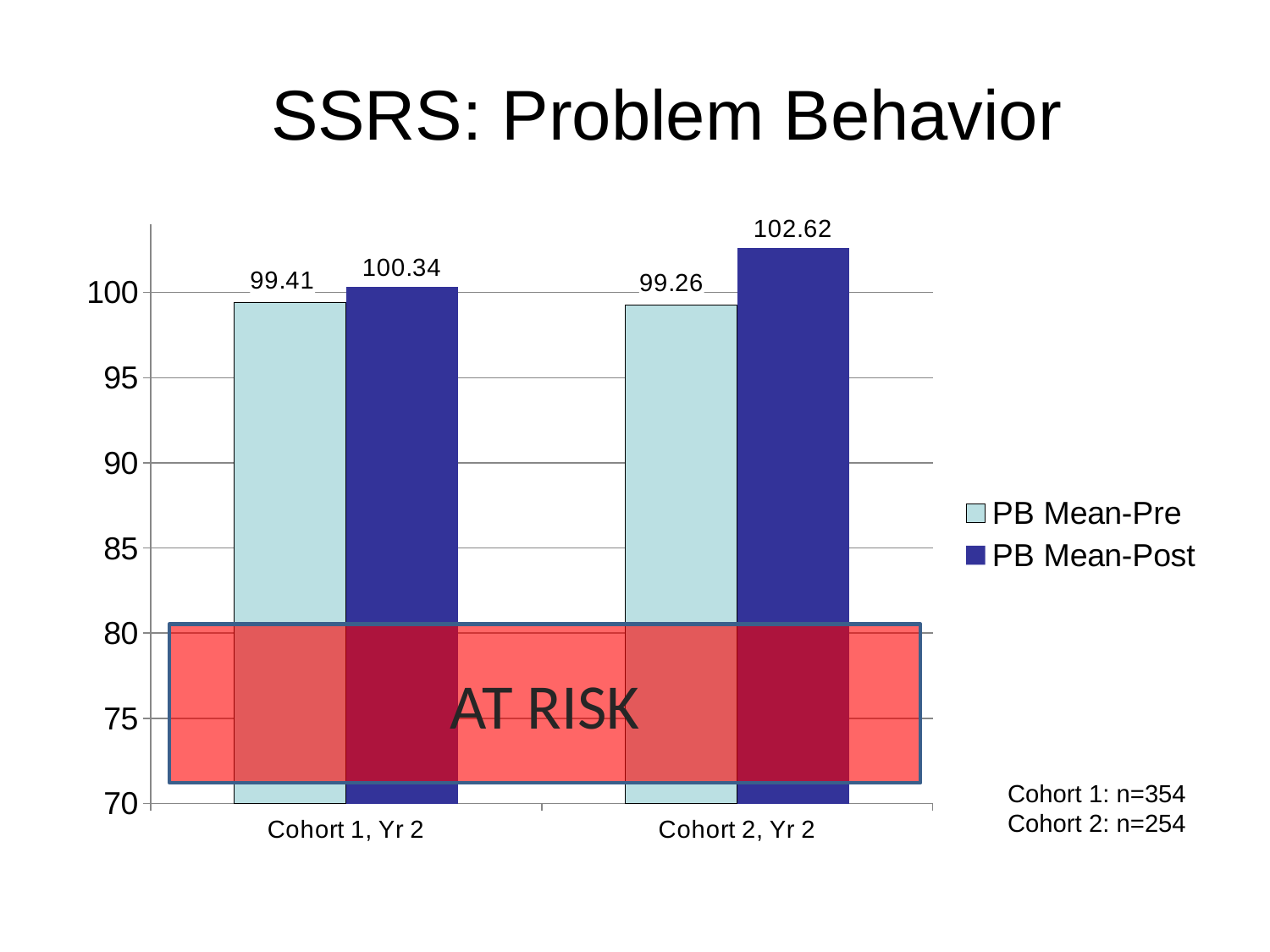
Which is larger: the PB Mean-Post value for Cohort 1, Yr 2 or the PB Mean-Post value for Cohort 2, Yr 2? PB Mean-Post for Cohort 2, Yr 2 What is the PB Mean-Pre value for Cohort 1, Yr 2? 99.41 What kind of chart is shown on the slide? bar chart What is the difference between the PB Mean-Post and PB Mean-Pre values for Cohort 1, Yr 2? 0.93 Which bar has the highest value on the chart? PB Mean-Post for Cohort 2, Yr 2 What is the difference between the PB Mean-Post and PB Mean-Pre values for Cohort 2, Yr 2? 3.36 What is the PB Mean-Post value for Cohort 2, Yr 2? 102.62 What label is written inside the red shaded band at the bottom of the chart? AT RISK Which bar has the lowest value on the chart? PB Mean-Pre for Cohort 2, Yr 2 Is the PB Mean-Pre value for Cohort 1, Yr 2 greater or less than 100? less What is the PB Mean-Post value for Cohort 1, Yr 2? 100.34 How many series does the legend list? 2